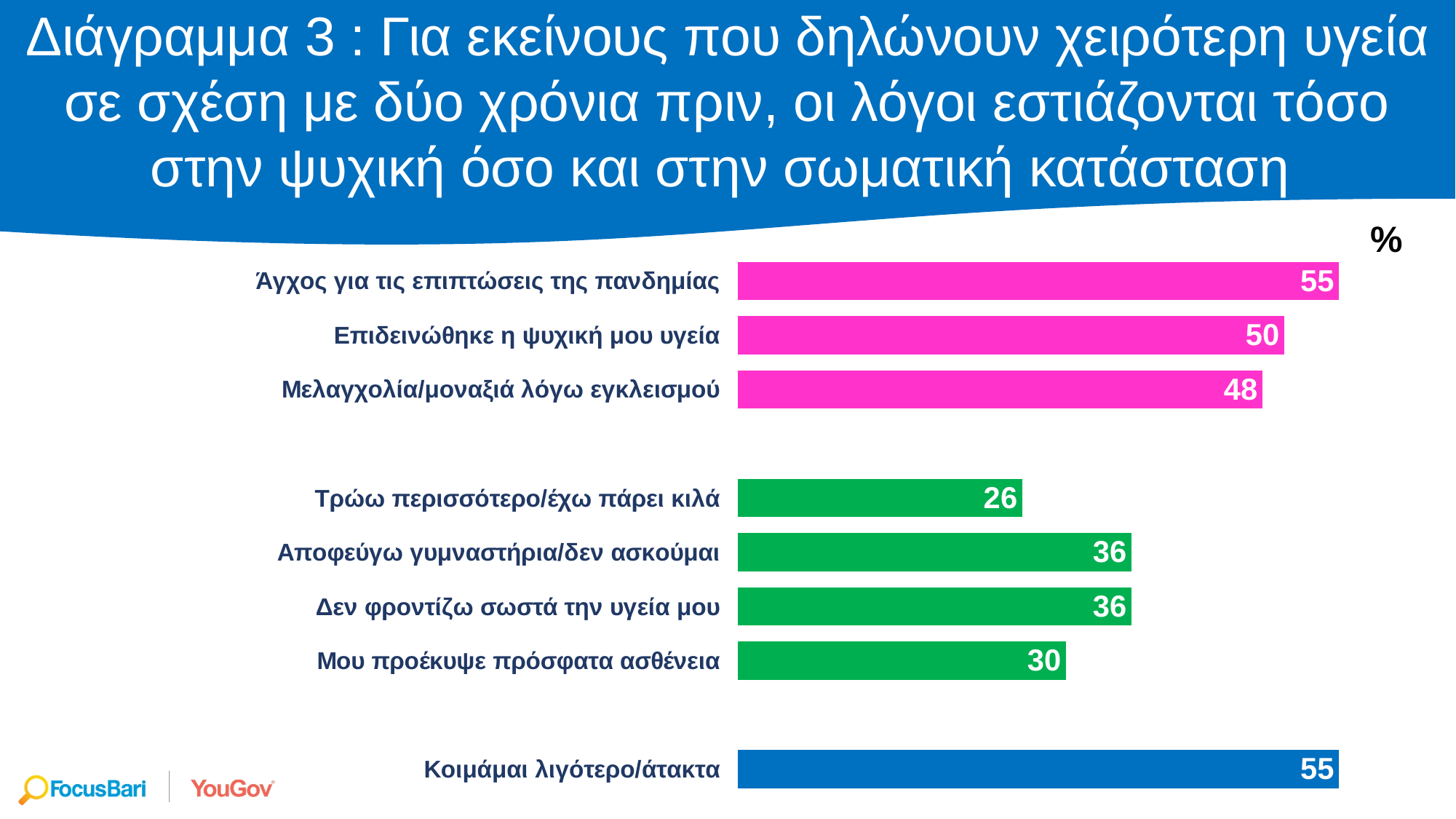
What is the value for 'Κοιμάμαι λιγότερο/άτακτα'? 55 What is the value for 'Άγχος για τις επιπτώσεις της πανδημίας'? 55 What is the value for 'Επιδεινώθηκε η ψυχική μου υγεία'? 50 What is the difference between 'Αποφεύγω γυμναστήρια/δεν ασκούμαι' and 'Τρώω περισσότερο/έχω πάρει κιλά'? 10 Which is larger: 'Επιδεινώθηκε η ψυχική μου υγεία' or 'Δεν φροντίζω σωστά την υγεία μου'? Επιδεινώθηκε η ψυχική μου υγεία What colour is the bar for 'Κοιμάμαι λιγότερο/άτακτα'? Blue What is the value for 'Μου προέκυψε πρόσφατα ασθένεια'? 30 What is the value for 'Μελαγχολία/μοναξιά λόγω εγκλεισμού'? 48 What is the difference between 'Άγχος για τις επιπτώσεις της πανδημίας' and 'Μελαγχολία/μοναξιά λόγω εγκλεισμού'? 7 What type of chart is shown on the slide? Bar chart Which category has the lowest value? Τρώω περισσότερο/έχω πάρει κιλά How many categories are shown in the chart? 8